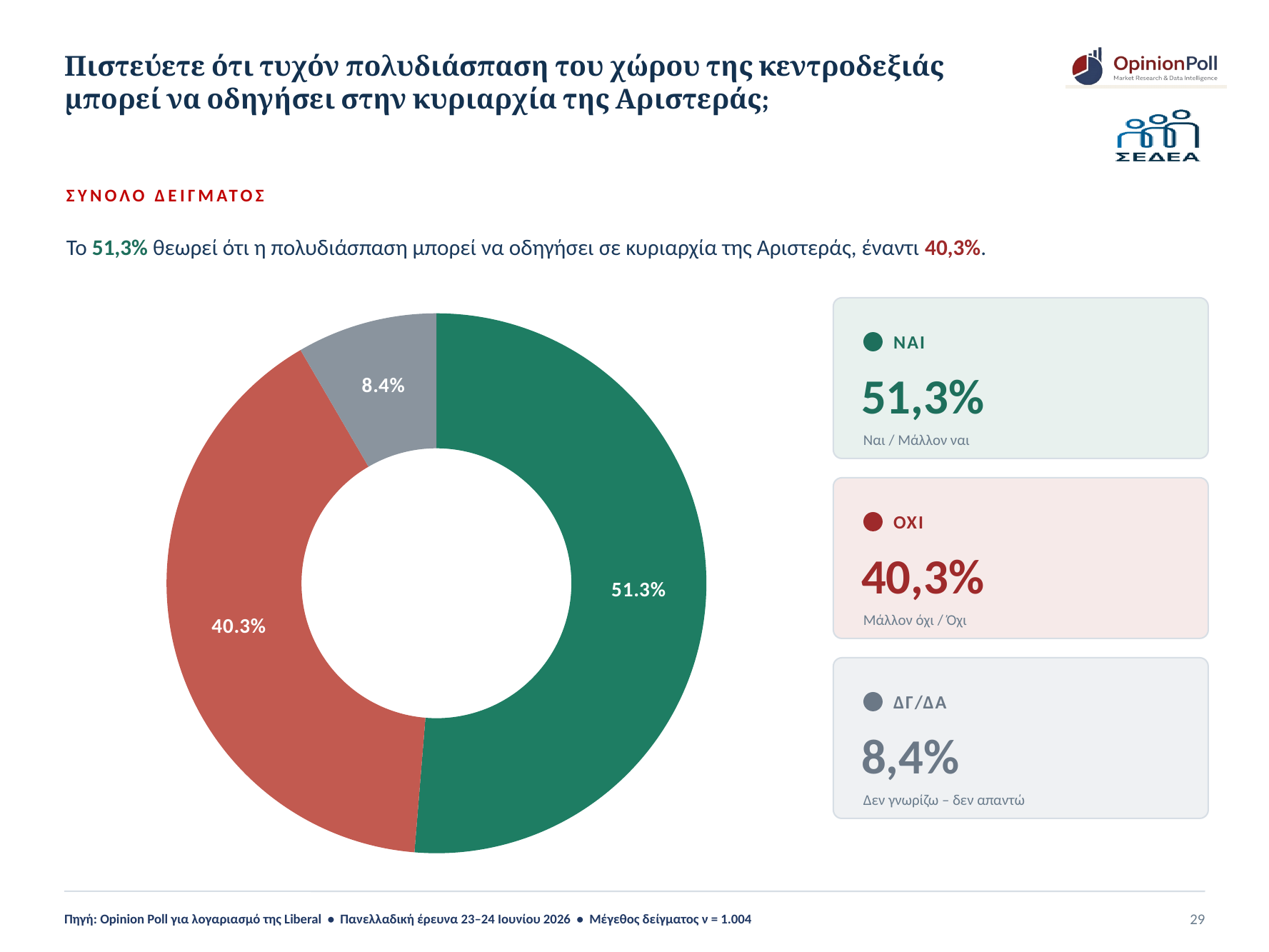
What type of chart is shown on the slide? Donut (pie) chart Which category has the smallest slice in the donut chart? ΔΓ/ΔΑ What share of the donut chart is the ΝΑΙ slice? 51.3% How many slices does the donut chart have? 3 What share of the donut chart is the ΟΧΙ slice? 40.3% What share of the donut chart is the ΔΓ/ΔΑ slice? 8.4% What colour is the ΟΧΙ slice in the donut chart? Red What colour is the ΝΑΙ slice in the donut chart? Green Which is larger, the ΝΑΙ slice or the ΟΧΙ slice? ΝΑΙ What is the difference in percentage points between the ΝΑΙ and ΟΧΙ slices? 11.0 percentage points What is the difference in percentage points between the ΟΧΙ and ΔΓ/ΔΑ slices? 31.9 percentage points Which category has the largest slice in the donut chart? ΝΑΙ